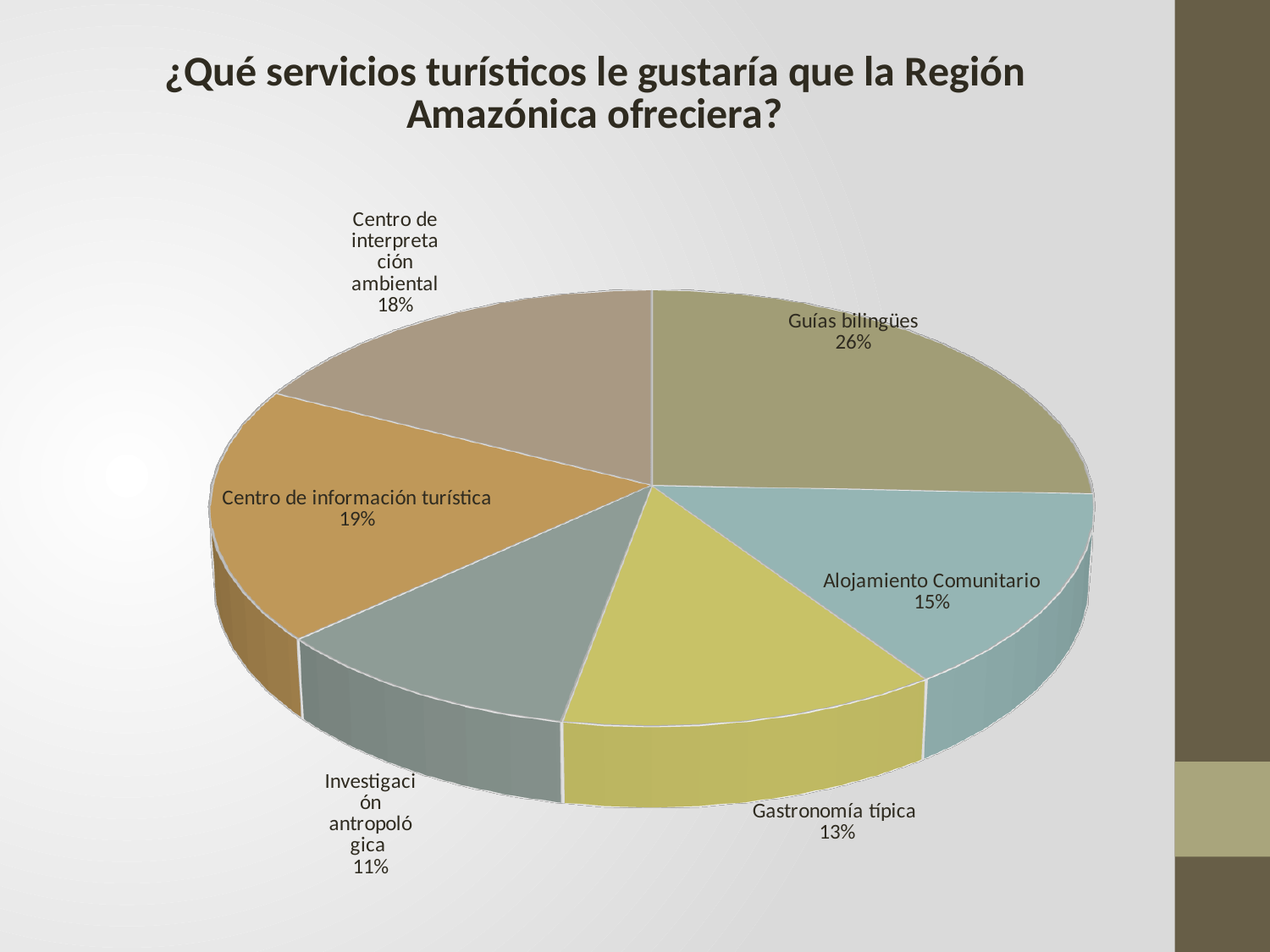
Which is larger, the share for Centro de información turística or the share for Centro de interpretación ambiental? Centro de información turística What is the difference between the shares of Guías bilingües and Investigación antropológica? 15% Which category has the smallest slice of the pie? Investigación antropológica What is the combined share of Gastronomía típica and Alojamiento Comunitario? 28% What share of the pie does Guías bilingües represent? 26% What is the value shown for Gastronomía típica? 13% How many categories are shown in the pie chart? 6 What is the value shown for Centro de información turística? 19% Which category has the largest slice of the pie? Guías bilingües What kind of chart is shown on the slide? Pie chart What is the title of the chart? ¿Qué servicios turísticos le gustaría que la Región Amazónica ofreciera? What is the value shown for Alojamiento Comunitario? 15%